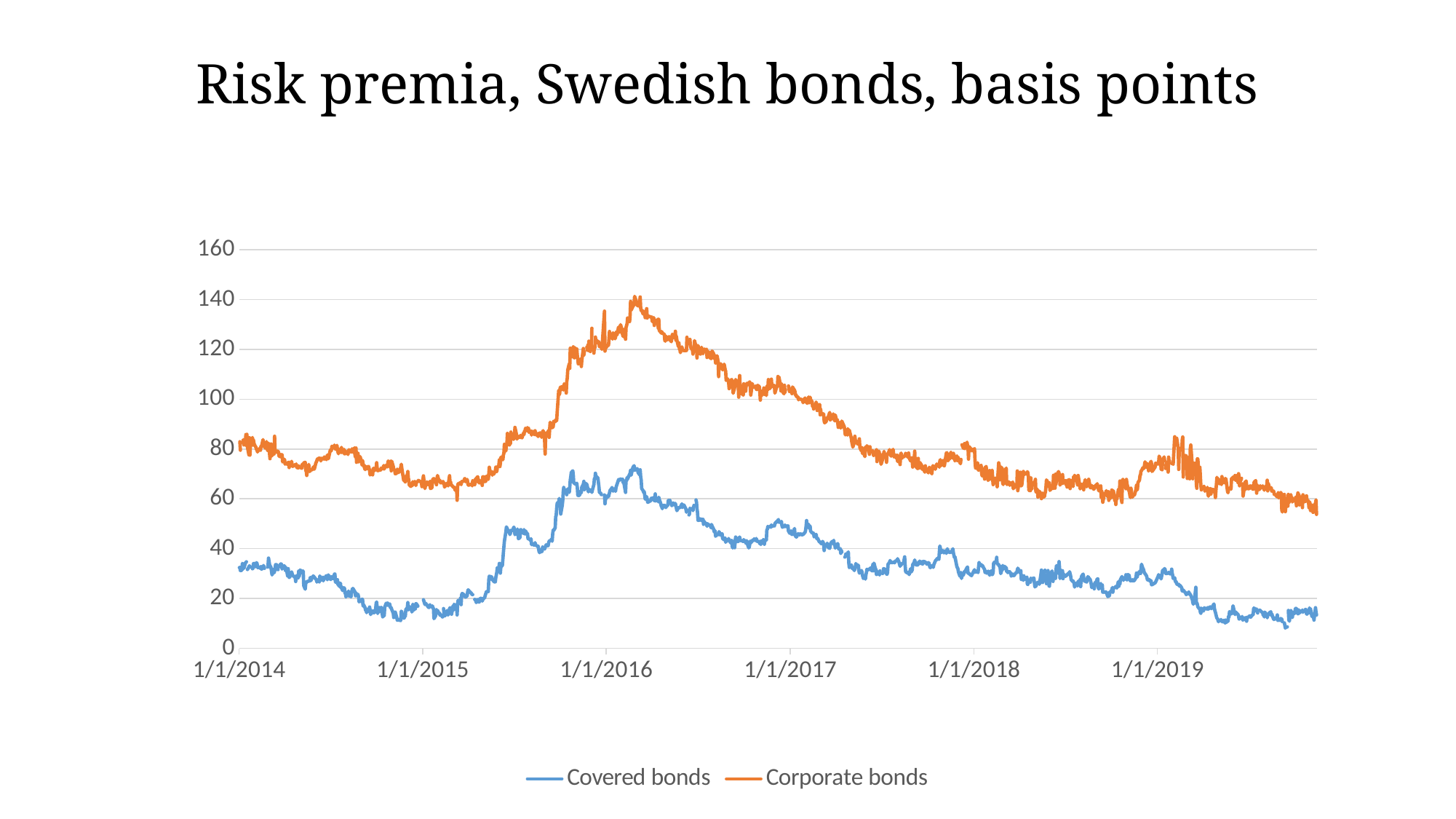
Is the peak value of Corporate bonds in early 2016 greater or less than 120? greater How many series does the legend list? 2 Is the value for Covered bonds at 1/1/2014 greater or less than 40? less What kind of chart is shown on the slide? line chart Which series has the higher values throughout the period, Covered bonds or Corporate bonds? Corporate bonds What is the title of the chart? Risk premia, Swedish bonds, basis points Is the value for Covered bonds at the end of 2019 greater or less than 20? less Which series is drawn in orange? Corporate bonds Does the Corporate bonds series rise or fall between 1/1/2016 and 1/1/2018? fall Does the Covered bonds series rise or fall between 1/1/2018 and the end of 2019? fall Around which year label does the Corporate bonds series reach its highest point? 1/1/2016